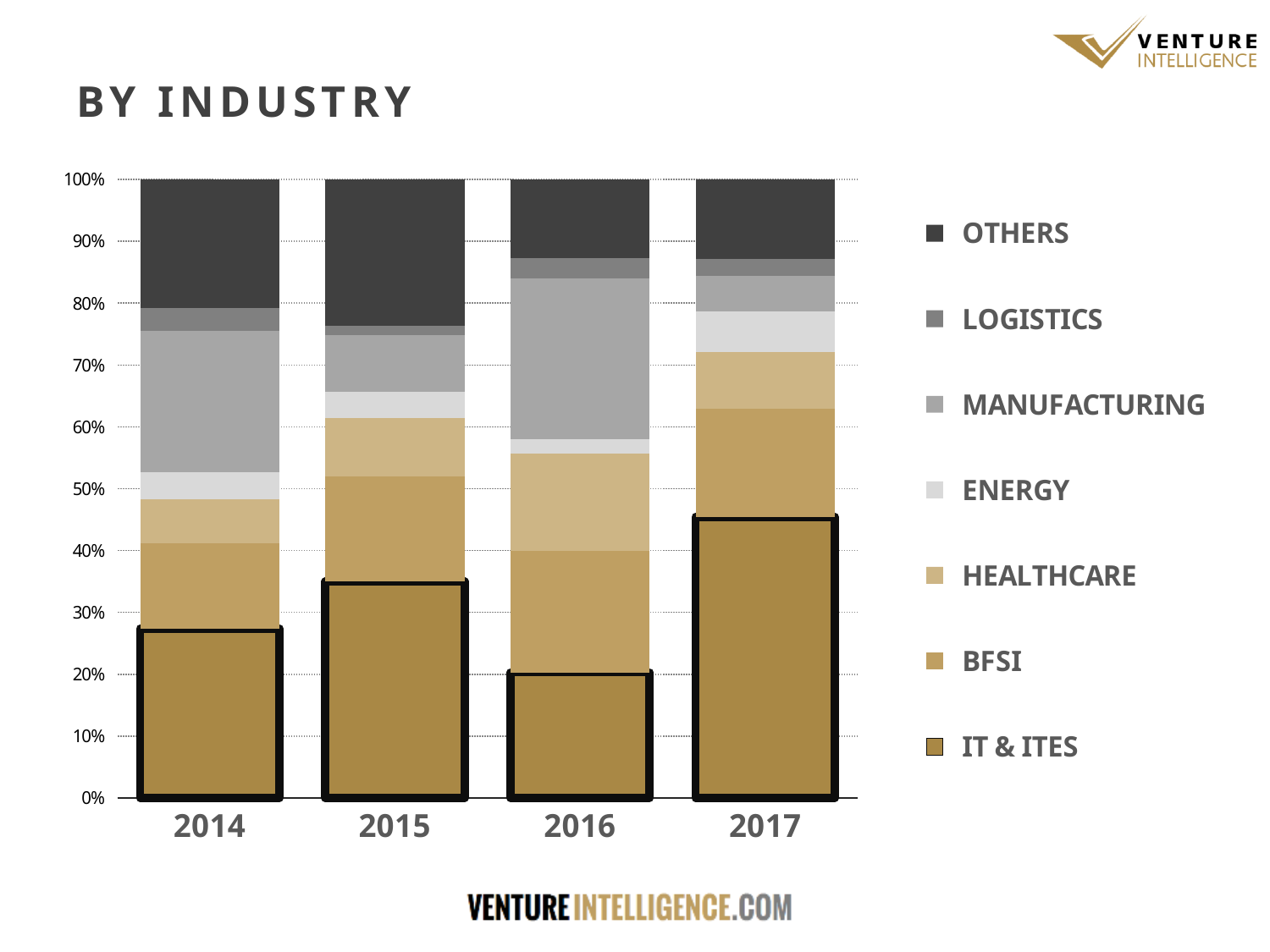
What is the total height of each stacked bar in the chart? 100% Is the IT & ITES share in 2017 greater or less than 40%? greater How many series does the legend list? 7 Which year has a larger IT & ITES share, 2015 or 2016? 2015 Is the IT & ITES share in 2015 greater or less than 30%? greater What kind of chart is shown on the slide? Stacked bar chart Is the IT & ITES share in 2014 greater or less than 30%? less What is the title of the chart? BY INDUSTRY Which year has the largest IT & ITES share? 2017 Which year has the smallest IT & ITES share? 2016 How many years are shown on the x axis of the chart? 4